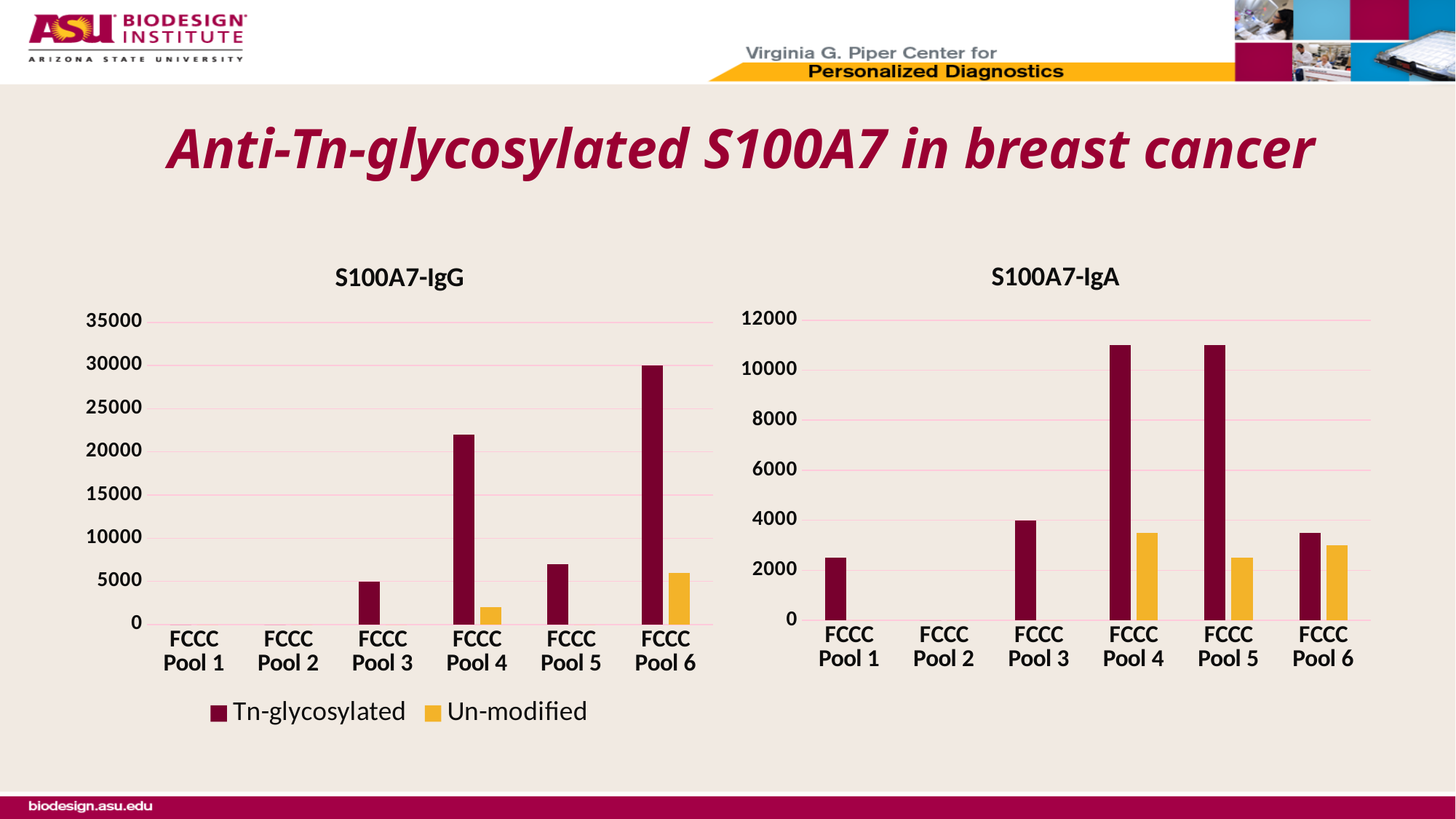
In the S100A7-IgA chart, what is the Tn-glycosylated value for FCCC Pool 3? 4000 In the S100A7-IgG chart, is the Tn-glycosylated value for FCCC Pool 4 greater or less than 20000? greater In the S100A7-IgA chart, is the Tn-glycosylated value for FCCC Pool 1 greater or less than 4000? less In the S100A7-IgA chart, is the Tn-glycosylated value for FCCC Pool 4 greater or less than 10000? greater In the S100A7-IgG chart, which pool has the highest Tn-glycosylated value? FCCC Pool 6 How many series does the legend list for the S100A7-IgG chart? 2 In the S100A7-IgA chart, which is larger for FCCC Pool 5: the Tn-glycosylated value or the Un-modified value? Tn-glycosylated What colour are the Un-modified bars in the S100A7-IgG chart? yellow What kind of chart is the S100A7-IgG chart? bar chart In the S100A7-IgG chart, what is the Tn-glycosylated value for FCCC Pool 3? 5000 How many pools are shown on the x axis of the S100A7-IgA chart? 6